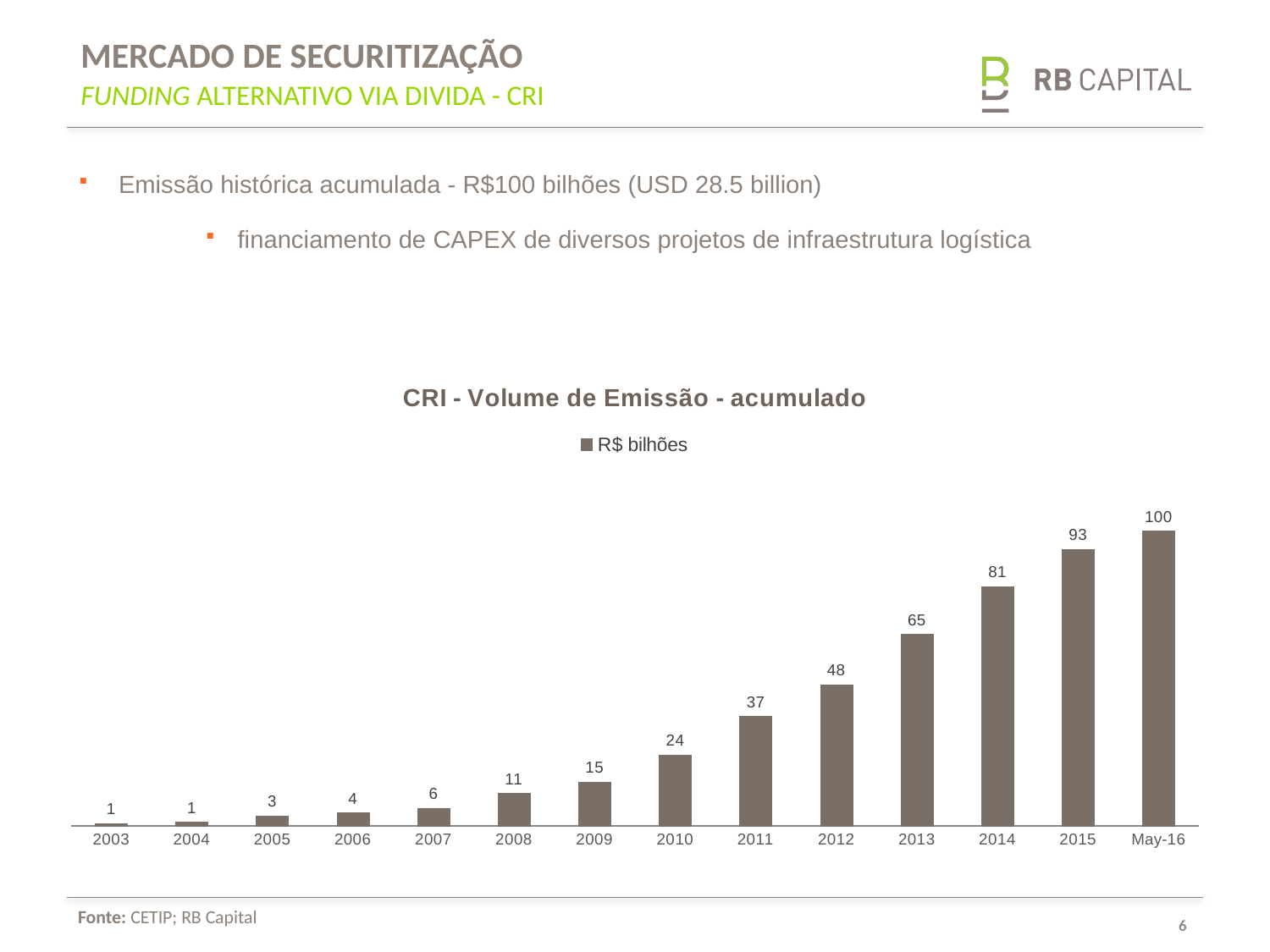
Which is larger, the value for 2013 or the value for 2012? 2013 What kind of chart is shown on the slide? Bar chart Which category has the highest value in the chart? May-16 What is the value for 2009 in the chart? 15 What is the difference between the values for 2011 and 2010? 13 How many categories are shown on the x axis of the chart? 14 What is the difference between the values for 2015 and 2014? 12 What is the value for May-16 in the chart? 100 Do the values rise or fall from 2003 to May-16? Rise What is the value for 2012 in the chart? 48 What is the title of the chart? CRI - Volume de Emissão - acumulado How many series does the legend list? 1